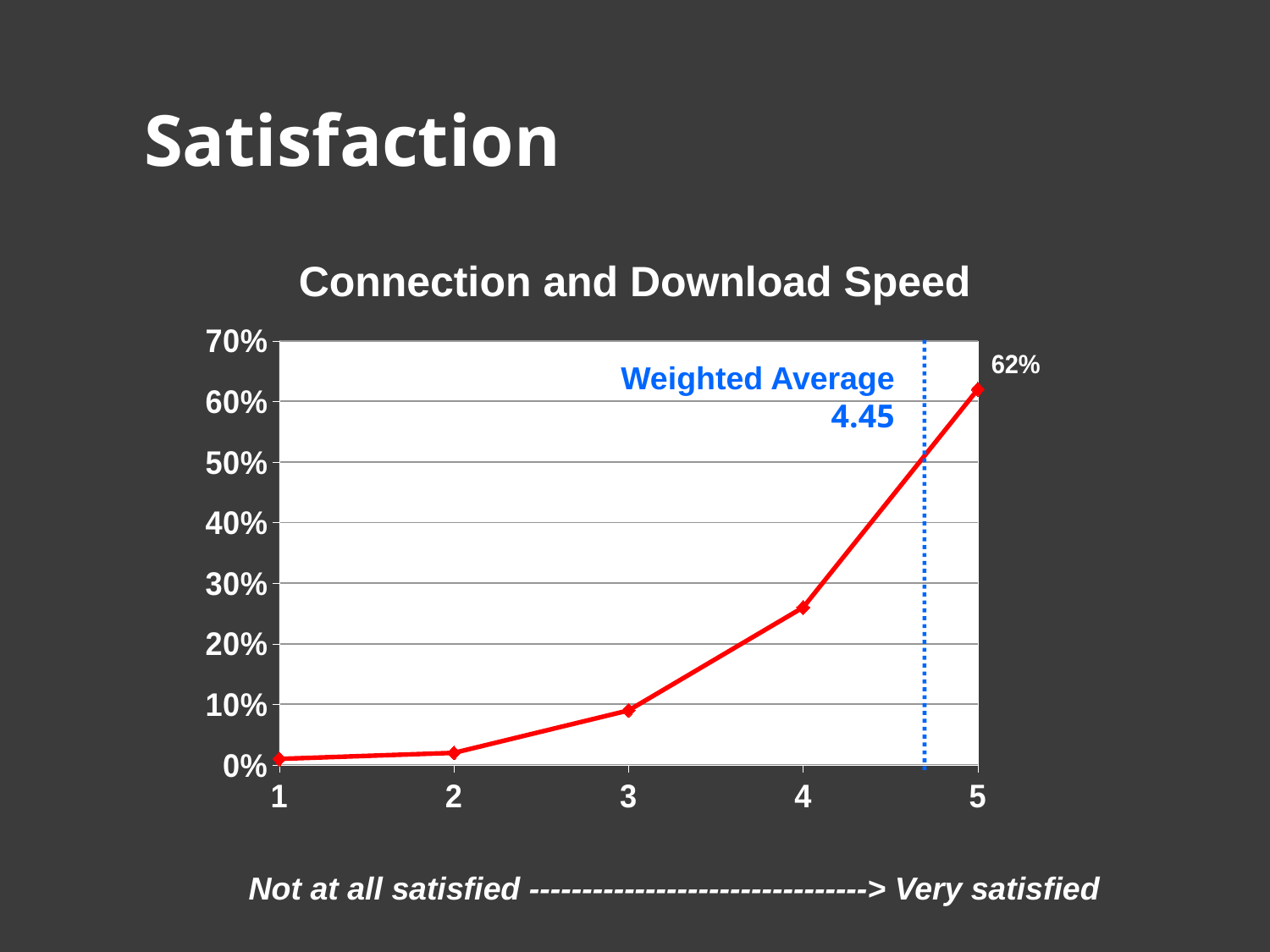
Which category has the lowest value? 1 How many points are plotted on the line? 5 What weighted average is shown on the chart? 4.45 What kind of chart is this? line chart Is the value for category 4 greater or less than 30%? less Is the value for category 4 greater or less than 20%? greater What is the value for category 5? 62% Do the values rise or fall from category 1 to category 5? rise Which category has the highest value? 5 What is the title of the chart? Connection and Download Speed Which has a larger value, category 3 or category 4? 4